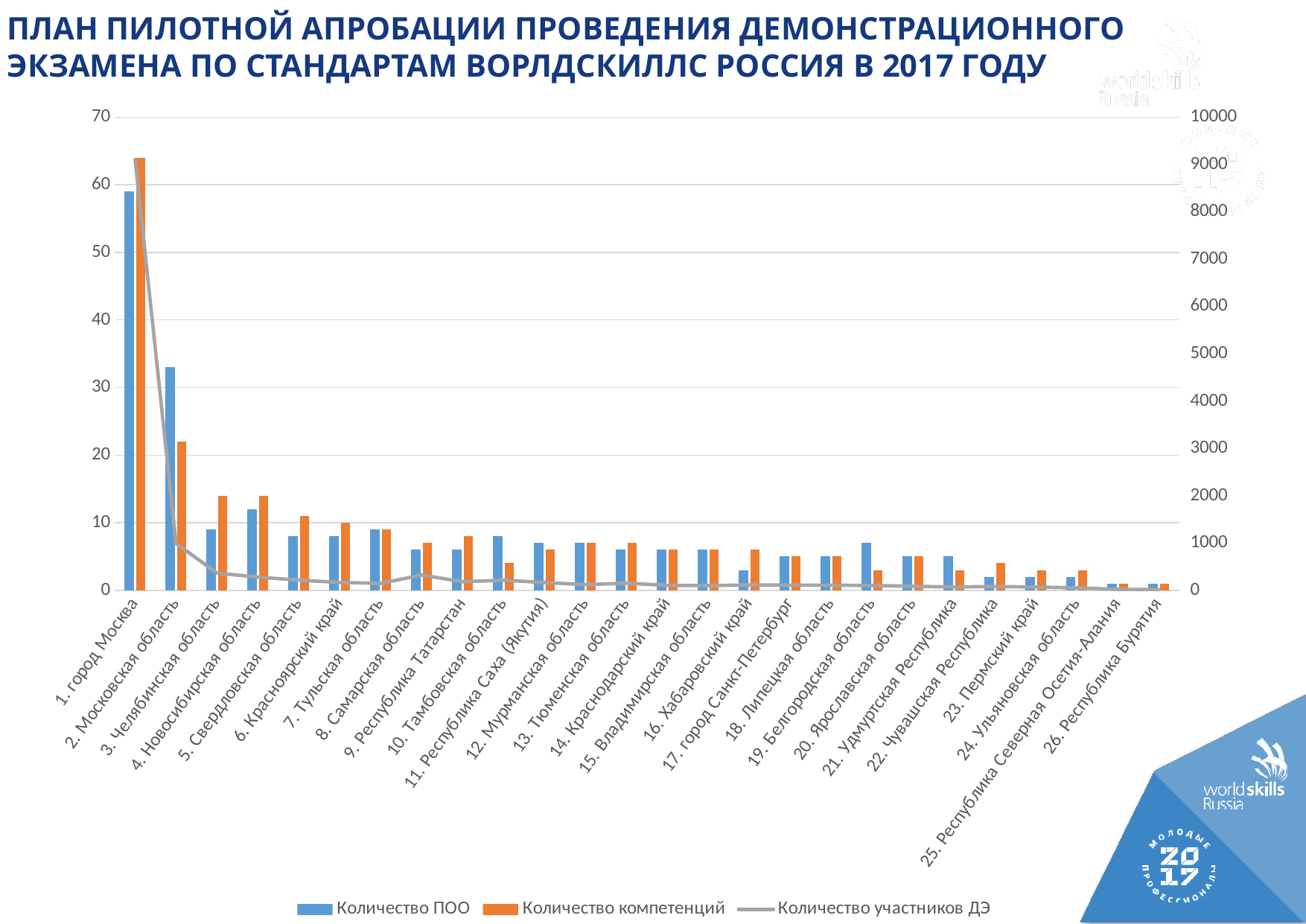
Which region has the highest value for Количество ПОО? 1. город Москва What is the maximum value shown on the right-hand vertical axis? 10000 For 5. Свердловская область, which is larger: Количество ПОО or Количество компетенций? Количество компетенций Is the Количество ПОО value for 1. город Москва greater or less than 50? greater Is the Количество ПОО value for 26. Республика Бурятия greater or less than 10? less Which region has the highest value for Количество компетенций? 1. город Москва Do the values for Количество участников ДЭ generally rise or fall from left to right along the x axis? fall How many regions (categories) are shown on the x axis of the chart? 26 How many series does the chart legend list? 3 What kind of chart is shown on the slide? A combined bar and line chart Is the Количество ПОО value for 2. Московская область greater or less than 30? greater